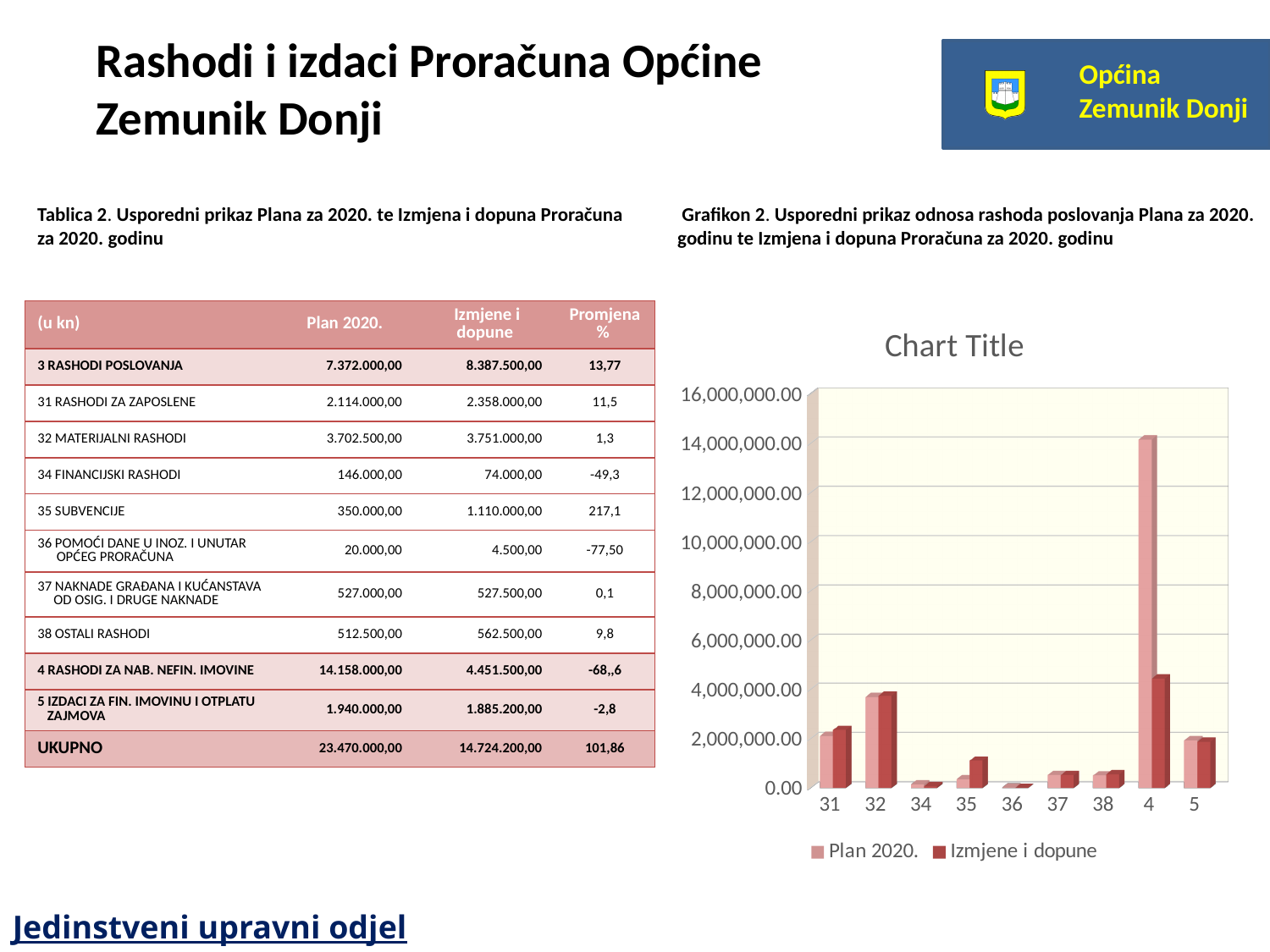
Is the Izmjene i dopune value for category 35 greater or less than 2,000,000.00? less Is the Plan 2020. value for category 4 greater or less than 12,000,000.00? greater What is the title shown above the chart? Chart Title Is the Plan 2020. value for category 32 greater or less than 2,000,000.00? greater For category 35, which series has the larger value, Plan 2020. or Izmjene i dopune? Izmjene i dopune For category 4, which series has the larger value, Plan 2020. or Izmjene i dopune? Plan 2020. How many categories are shown on the x axis of the chart? 9 How many series does the chart legend list? 2 Which category has the highest Izmjene i dopune value in the chart? 4 Which category has the highest Plan 2020. value in the chart? 4 What kind of chart is shown on the slide? bar chart